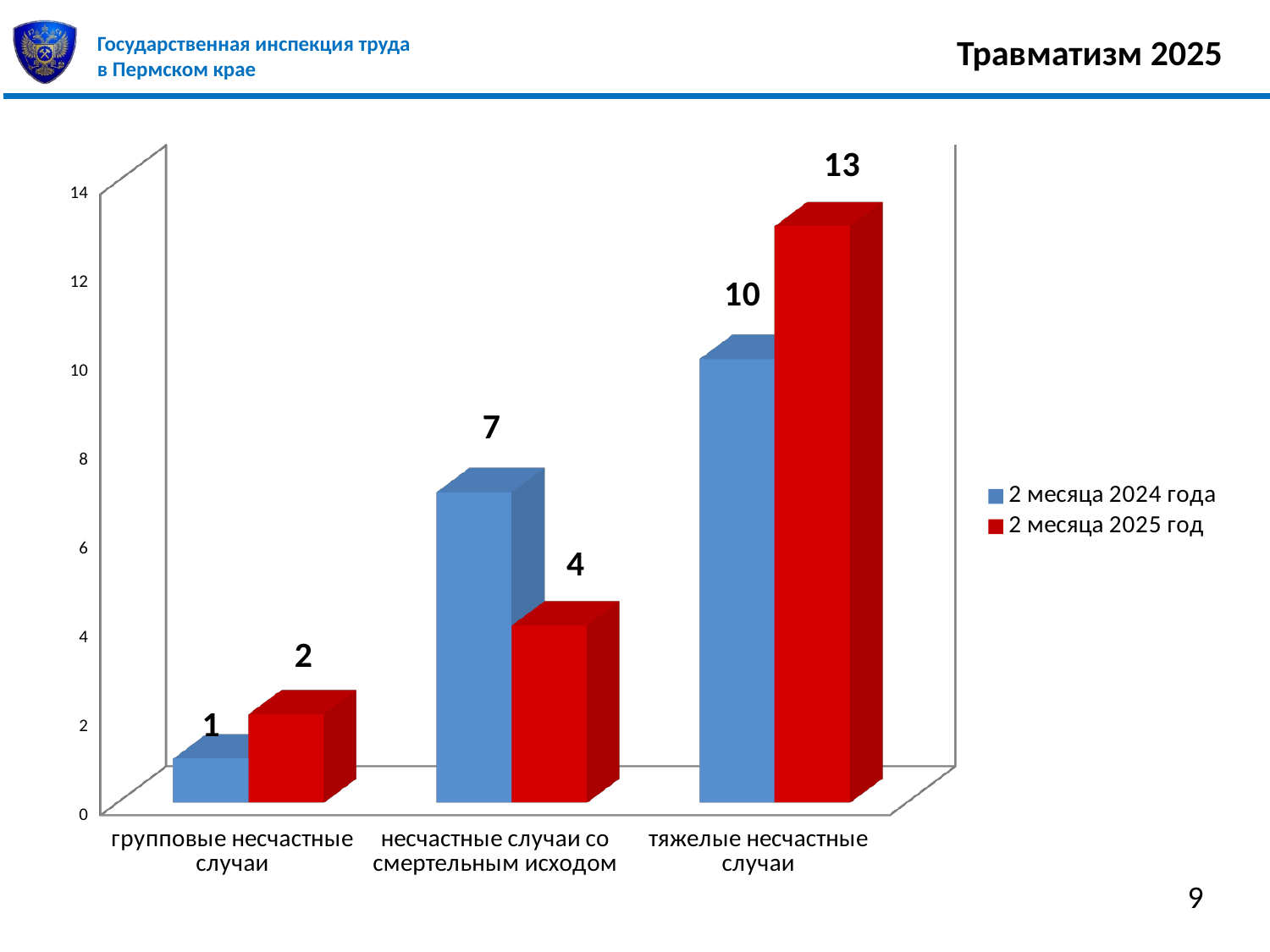
Which category has the lowest value in the '2 месяца 2024 года' series? групповые несчастные случаи What is the difference between the '2 месяца 2024 года' and '2 месяца 2025 год' values for 'несчастные случаи со смертельным исходом'? 3 How many series does the legend list? 2 What is the value for 'несчастные случаи со смертельным исходом' in the '2 месяца 2025 год' series? 4 How many categories are shown on the x axis? 3 What kind of chart is shown on the slide? bar chart What is the value for 'групповые несчастные случаи' in the '2 месяца 2024 года' series? 1 For 'несчастные случаи со смертельным исходом', which series has the larger value: '2 месяца 2024 года' or '2 месяца 2025 год'? 2 месяца 2024 года What is the difference between the '2 месяца 2025 год' and '2 месяца 2024 года' values for 'тяжелые несчастные случаи'? 3 Which category has the highest value in the '2 месяца 2025 год' series? тяжелые несчастные случаи What is the value for 'тяжелые несчастные случаи' in the '2 месяца 2024 года' series? 10 What colour represents the '2 месяца 2025 год' series? red